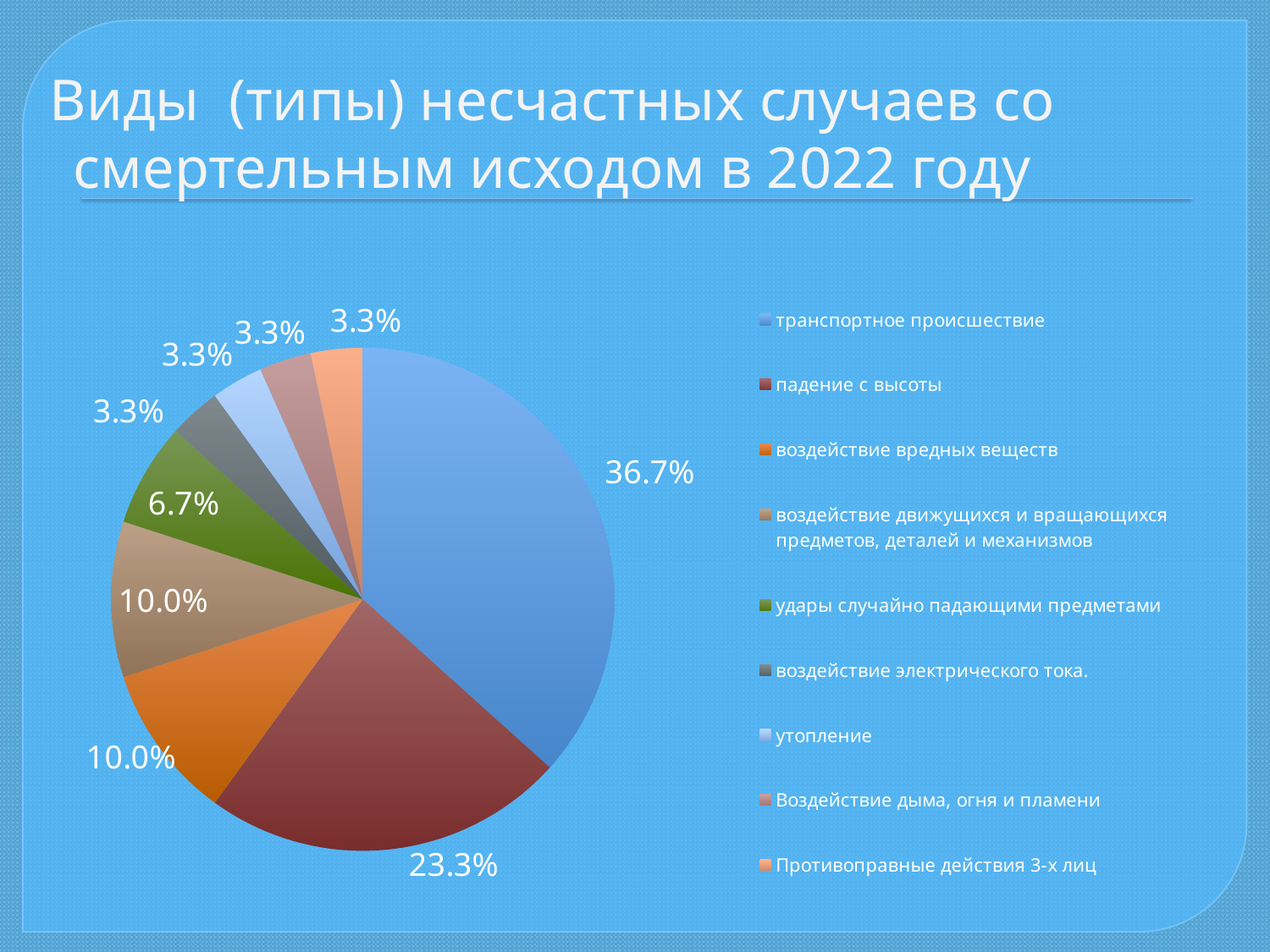
What share of the pie does "транспортное происшествие" take? 36.7% What is the value shown for "воздействие вредных веществ"? 10.0% Which category has the largest slice of the pie? транспортное происшествие What kind of chart is shown on the slide? pie chart What is the value shown for "падение с высоты"? 23.3% What is the value shown for "утопление"? 3.3% How many categories have a value of 3.3%? 4 What is the difference between the values for "транспортное происшествие" and "падение с высоты"? 13.4% What is the value shown for "удары случайно падающими предметами"? 6.7% What is the title of the slide? Виды (типы) несчастных случаев со смертельным исходом в 2022 году How many categories does the legend list? 9 Which is larger: the value for "падение с высоты" or the value for "воздействие вредных веществ"? падение с высоты